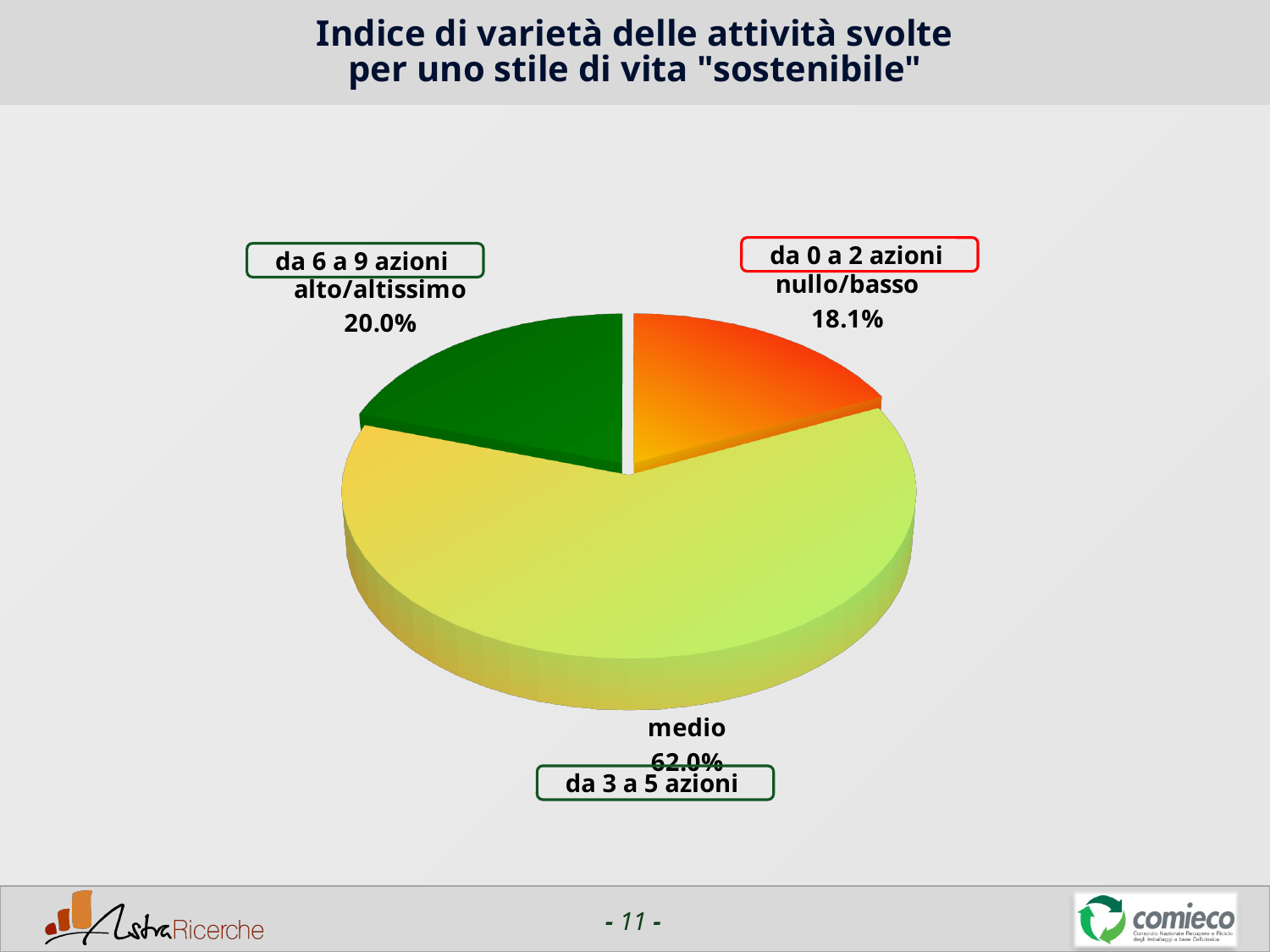
Which range of actions corresponds to the "medio" slice? da 3 a 5 azioni What colour is the "alto/altissimo" slice? green Which is larger, the "alto/altissimo" slice or the "nullo/basso" slice? alto/altissimo What kind of chart is shown on the slide? pie chart Which slice of the pie is the largest? medio What is the difference in percentage points between the "medio" slice and the "alto/altissimo" slice? 42.0 What is the difference in percentage points between the "alto/altissimo" slice and the "nullo/basso" slice? 1.9 What percentage is shown for the "alto/altissimo" slice? 20.0% How many slices does the pie chart have? 3 Which slice of the pie is the smallest? nullo/basso What percentage is shown for the "medio" slice? 62.0% What percentage is shown for the "nullo/basso" slice? 18.1%